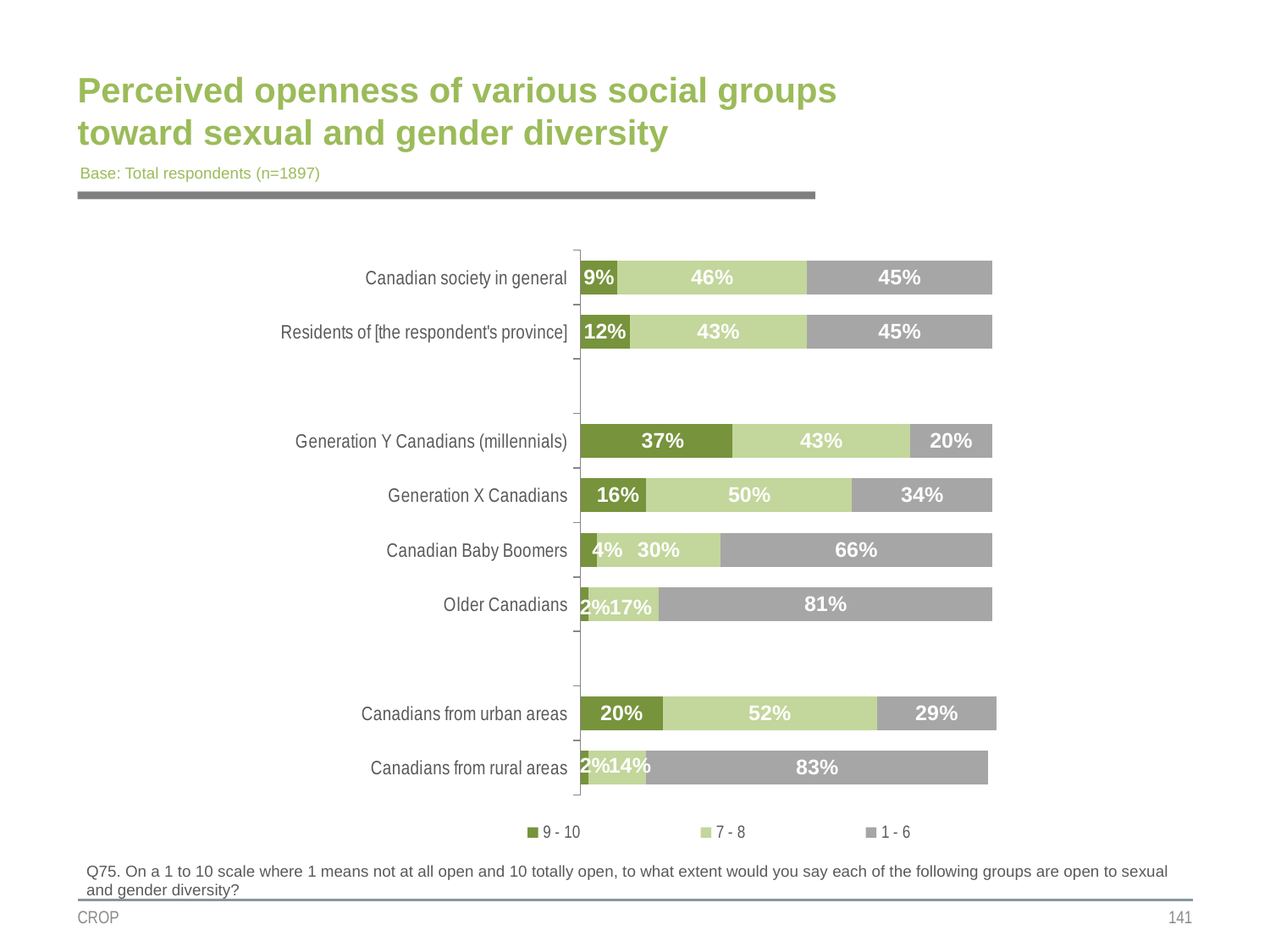
How many social groups are shown in the chart? 8 Which is larger: the 7 - 8 value for Canadians from urban areas or for Generation X Canadians? Canadians from urban areas Which group has the highest 9 - 10 value? Generation Y Canadians (millennials) What are the three legend entries in the chart? 9 - 10, 7 - 8, 1 - 6 What percentage of respondents rated Generation Y Canadians (millennials) 9 - 10 on openness? 37% What kind of chart is shown on the slide? Stacked bar chart Which group has the lowest 1 - 6 value? Generation Y Canadians (millennials) What is the difference between the 1 - 6 values for Canadian Baby Boomers and Generation X Canadians? 32 percentage points What is the 1 - 6 value for Canadians from rural areas? 83% What is the 7 - 8 value for Generation X Canadians? 50% How many series does the legend list? 3 What is the total of the stacked bar for Generation Y Canadians (millennials)? 100%